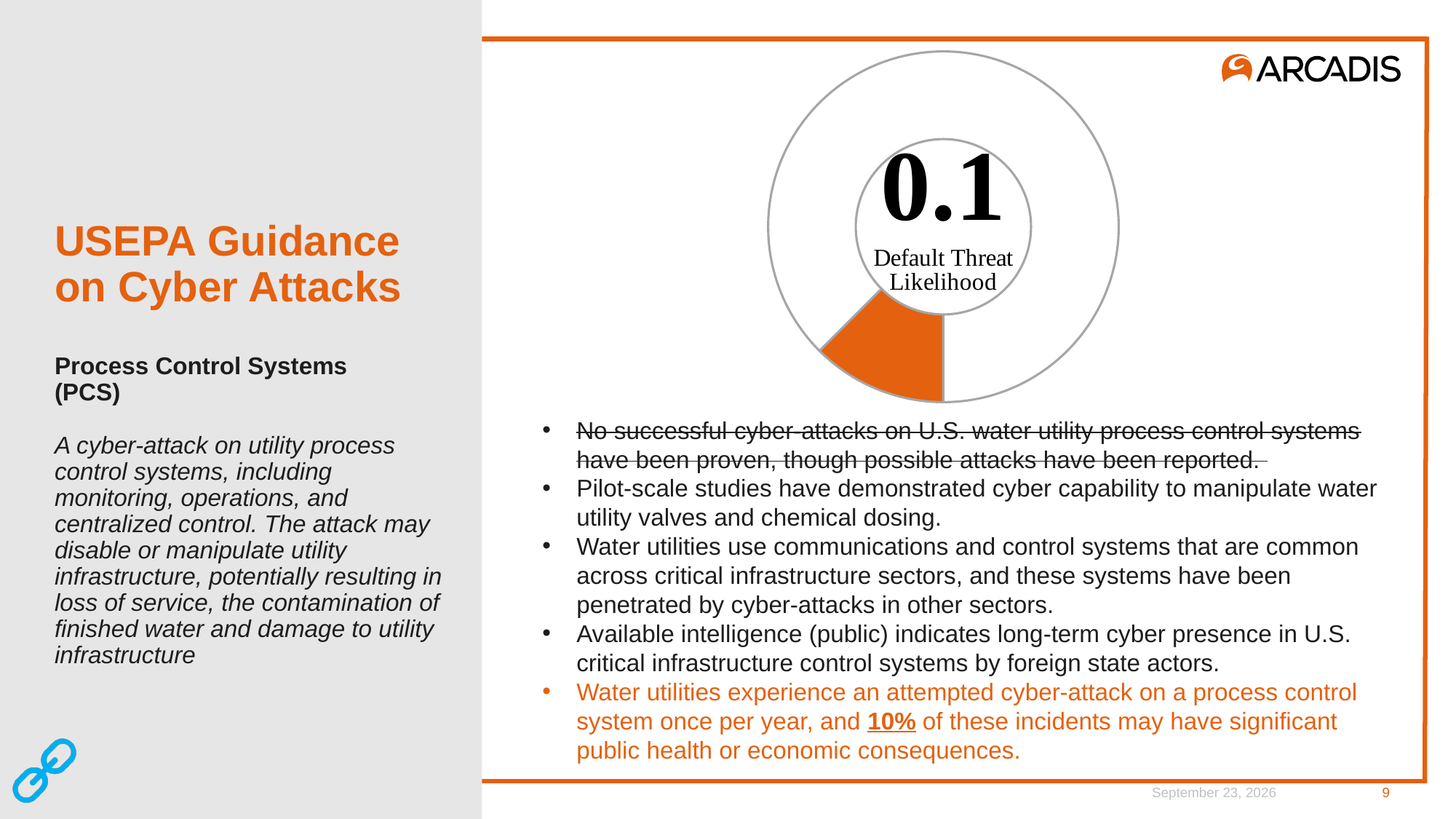
What label appears beneath the number in the centre of the doughnut chart? Default Threat Likelihood What value is printed in the centre of the doughnut chart? 0.1 Does the doughnut chart display a legend? No What share of the doughnut chart does the orange segment represent? 0.1 What kind of chart is shown on the slide? doughnut chart How many coloured (filled) segments does the doughnut chart have? 1 Is the orange segment of the doughnut chart greater or less than half of the ring? less What colour is the filled segment of the doughnut chart? orange Which is larger in the doughnut chart, the orange segment or the unfilled remainder of the ring? the unfilled remainder